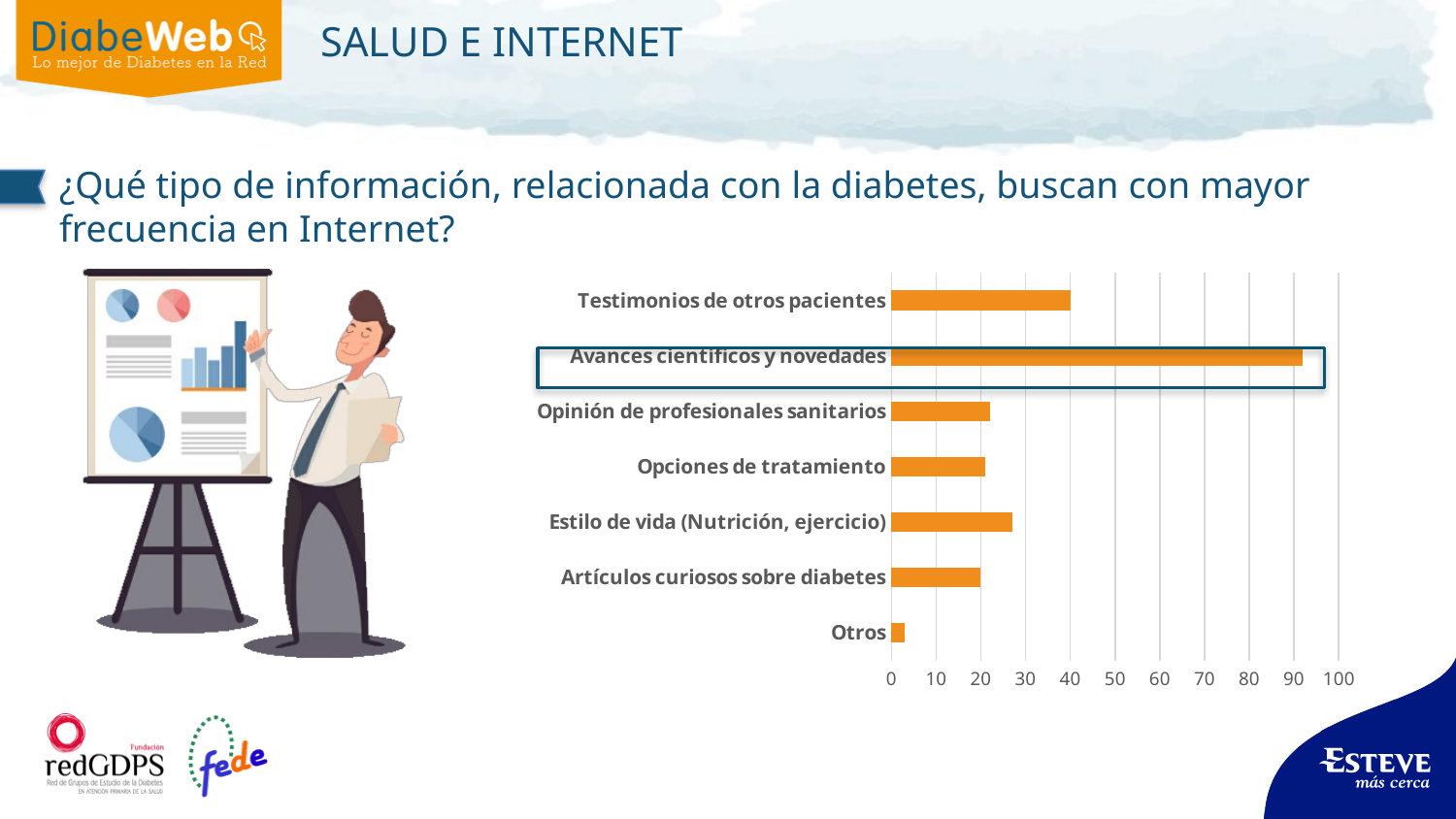
Is the value for Estilo de vida (Nutrición, ejercicio) greater or less than 20? greater Which category has the lowest value in the bar chart? Otros Is the value for Testimonios de otros pacientes greater or less than 30? greater Which is larger, the value for Testimonios de otros pacientes or the value for Avances científicos y novedades? Avances científicos y novedades Which category has the highest value in the bar chart? Avances científicos y novedades Is the value for Avances científicos y novedades greater or less than 80? greater What is the maximum value shown on the chart's horizontal axis? 100 What kind of chart is shown on the slide? bar chart How many categories does the bar chart show? 7 Which is larger, the value for Estilo de vida (Nutrición, ejercicio) or the value for Opinión de profesionales sanitarios? Estilo de vida (Nutrición, ejercicio)